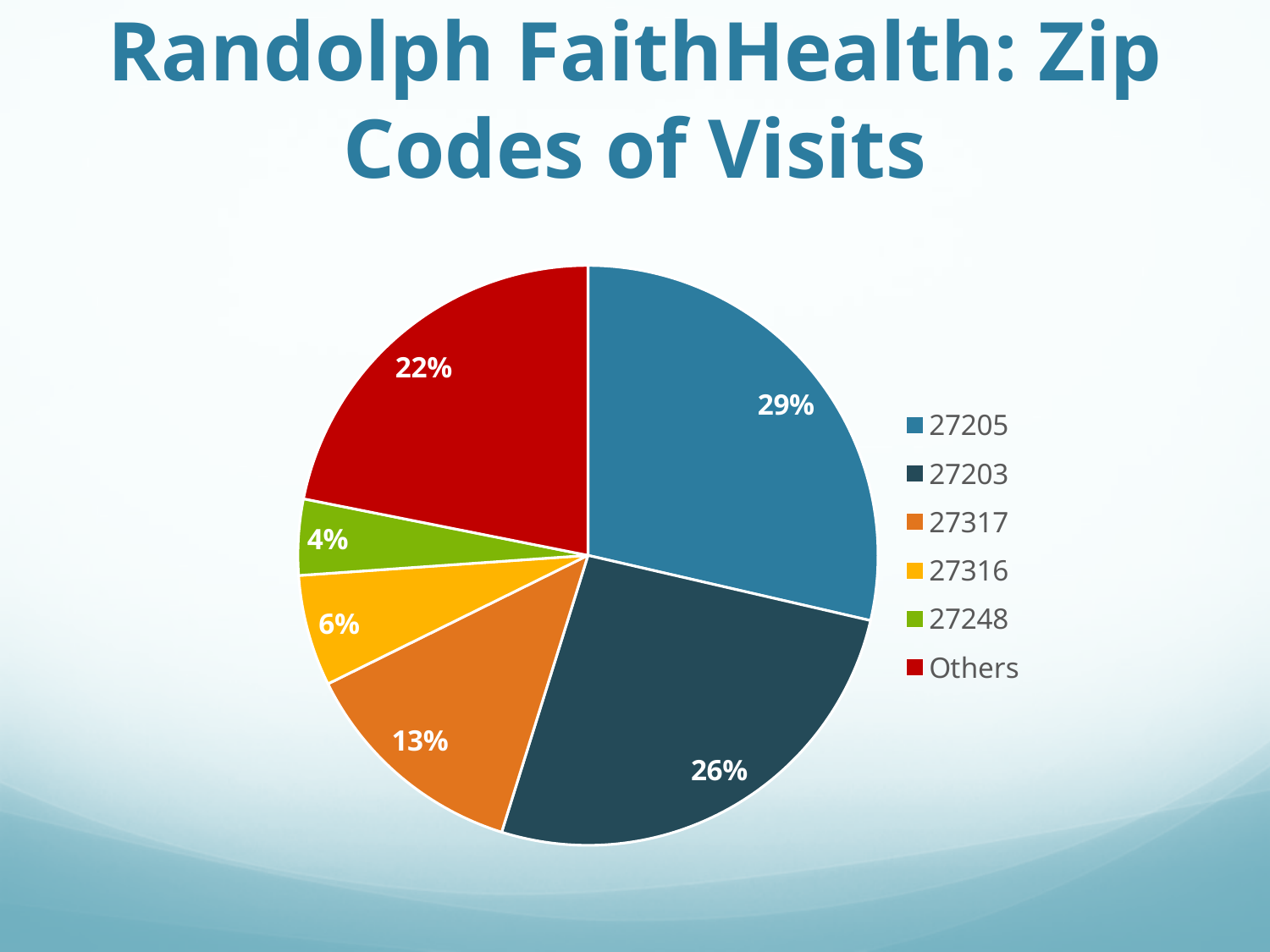
What share of visits is from zip code 27203? 26% How many categories does the pie chart show? 6 What share of visits is from zip code 27248? 4% What share of visits is from zip code 27205? 29% What type of chart is shown on the slide? Pie chart Which has a larger share of visits, 27317 or Others? Others Which zip code category has the smallest share of visits? 27248 What is the difference in percentage points between the shares for 27205 and 27203? 3% What share of visits falls under Others? 22% Which zip code category has the largest share of visits? 27205 What share of visits is from zip code 27316? 6% What share of visits is from zip code 27317? 13%